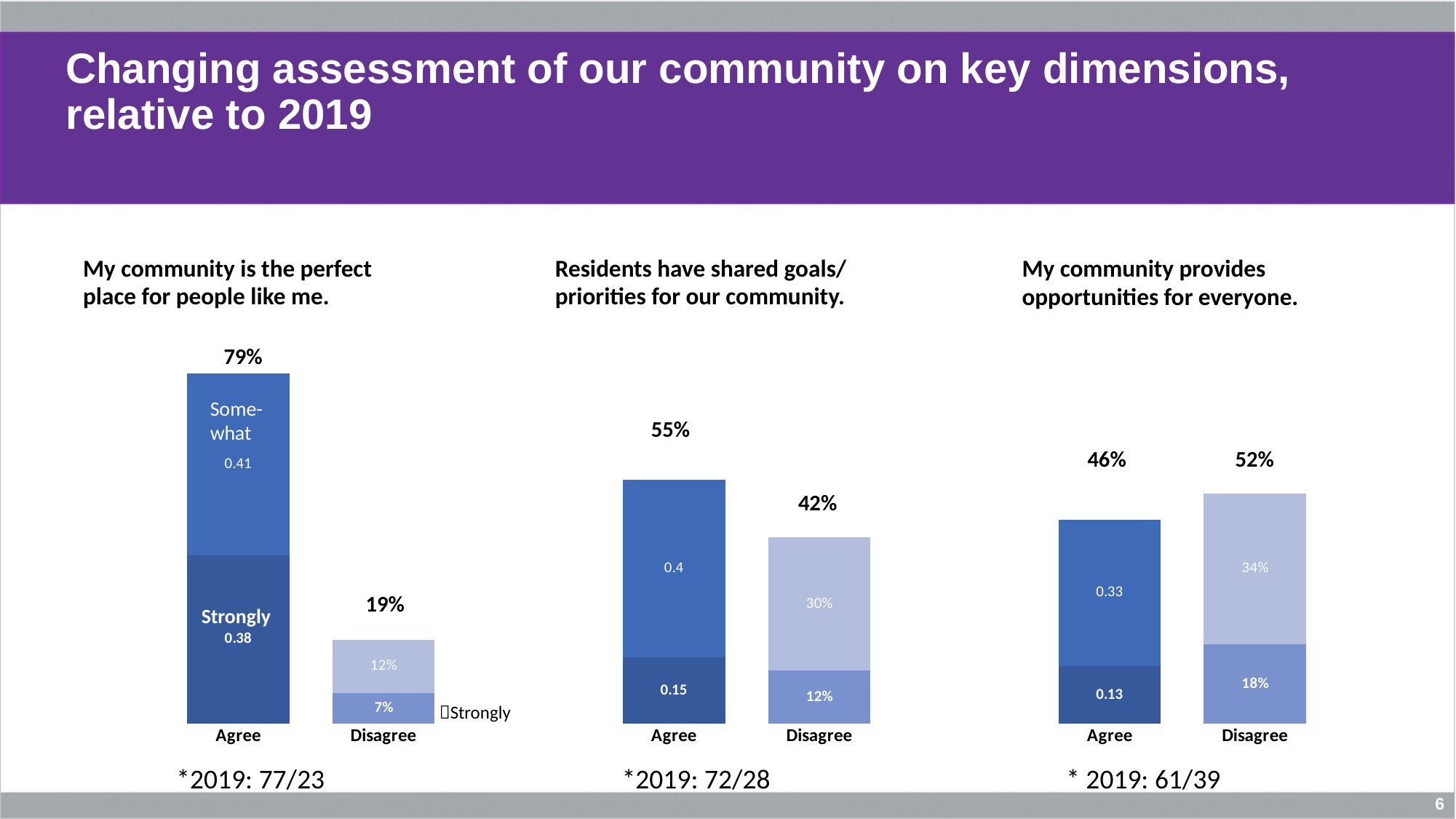
In the chart 'Residents have shared goals/priorities for our community.', what is the difference between the Agree total and the Disagree total? 13% In the chart 'Residents have shared goals/priorities for our community.', what is the total percentage for Agree? 55% In the chart 'My community provides opportunities for everyone.', what is the total percentage for Disagree? 52% What type of chart is used on this slide? Stacked bar chart In the chart 'My community is the perfect place for people like me.', what is the total percentage for Disagree? 19% How many bars are shown in the chart 'My community provides opportunities for everyone.'? 2 What 2019 Agree/Disagree figures are noted below the chart 'My community provides opportunities for everyone.'? 61/39 In the chart 'My community is the perfect place for people like me.', what is the difference between the Agree total and the Disagree total? 60% In the chart 'My community is the perfect place for people like me.', what is the value of the Strongly segment of the Agree bar? 0.38 In the chart 'My community is the perfect place for people like me.', what is the total percentage for Agree? 79% In the chart 'My community provides opportunities for everyone.', which bar is taller, Agree or Disagree? Disagree In the chart 'Residents have shared goals/priorities for our community.', what is the value of the bottom segment of the Disagree bar? 12%